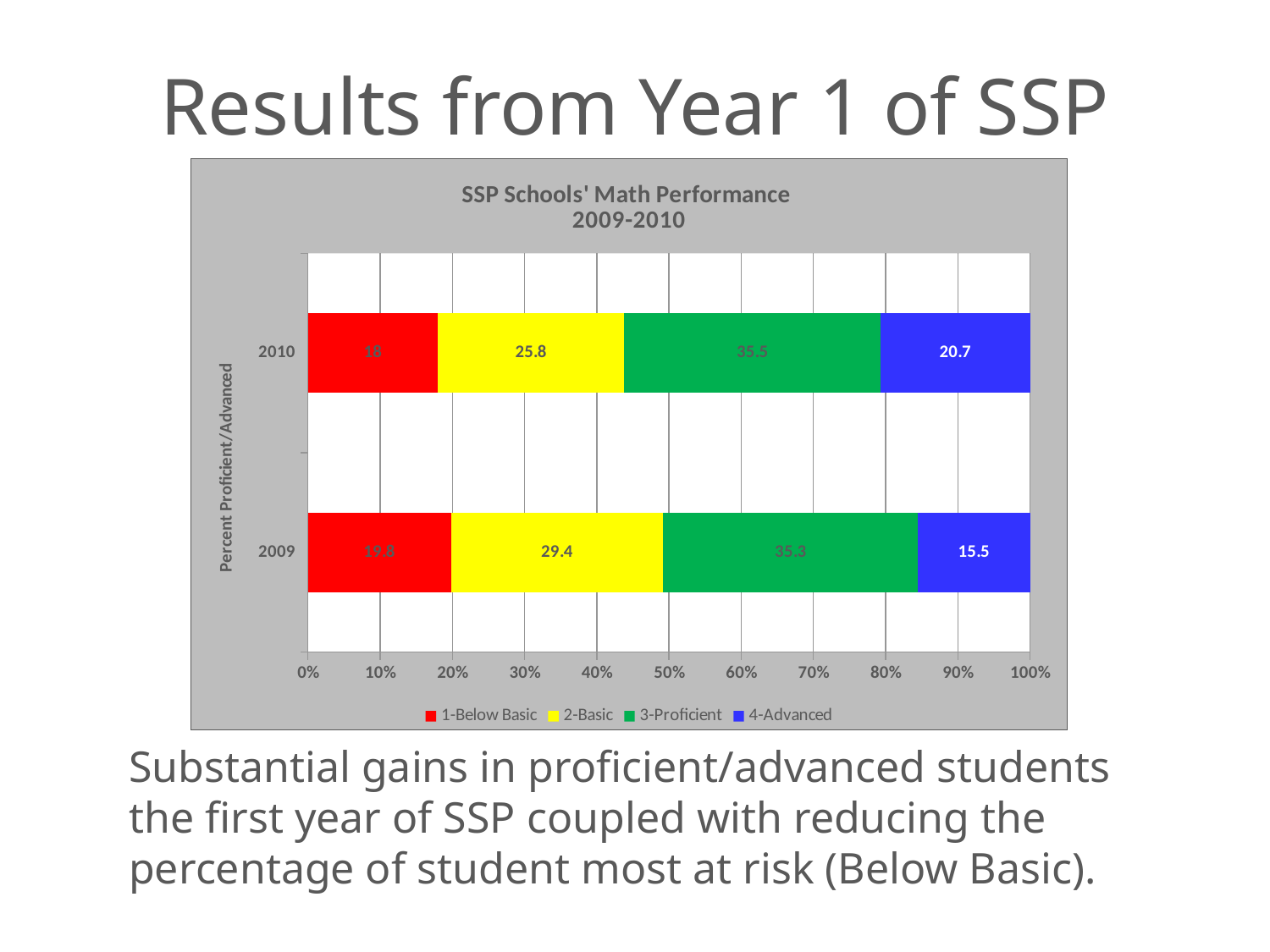
What is the value for 2-Basic in 2009? 29.4 What is the value for 3-Proficient in 2009? 35.3 Which year has the larger 4-Advanced value, 2009 or 2010? 2010 What is the value for 1-Below Basic in 2010? 18 What is the difference between the 2-Basic values for 2009 and 2010? 3.6 What is the total of the stacked bar for 2010? 100 How many years are shown on the chart? 2 Which year has the larger 1-Below Basic value, 2009 or 2010? 2009 What is the difference between the 4-Advanced values for 2010 and 2009? 5.2 What kind of chart is shown? Stacked bar chart How many series does the legend list? 4 What is the value for 4-Advanced in 2010? 20.7